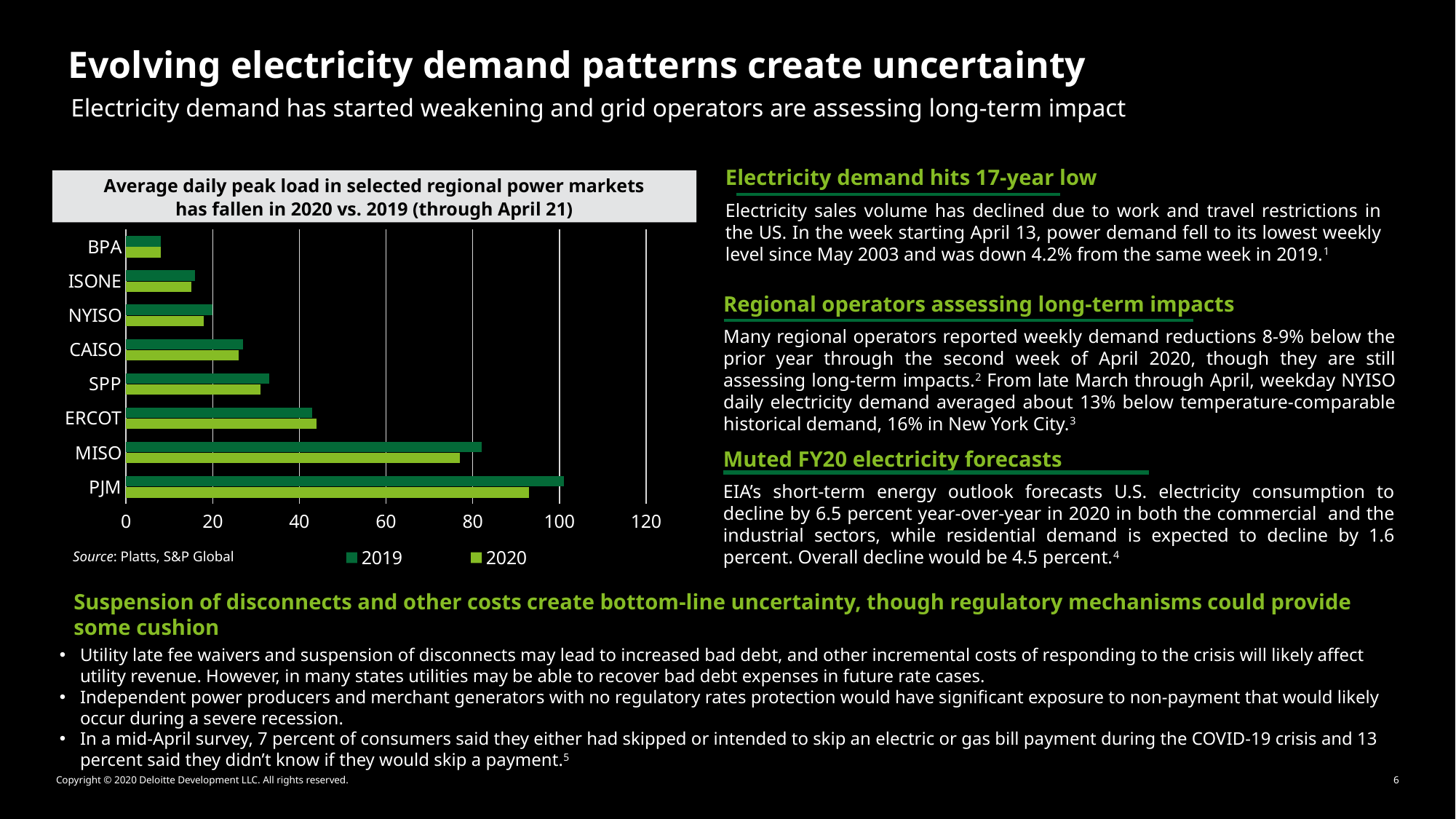
How many series does the chart legend list? 2 How many regional power markets are shown on the chart? 8 Is the 2020 value for ERCOT greater or less than 40? greater Is the 2019 value for BPA greater or less than 20? less Is the 2020 value for PJM greater or less than 100? less What kind of chart is shown on the slide? bar chart Which regional power market has the lowest average daily peak load in 2020? BPA What source is cited for the chart data? Platts, S&P Global Which is larger, the 2019 value for MISO or the 2019 value for ERCOT? MISO Which regional power market has the highest average daily peak load in 2019? PJM